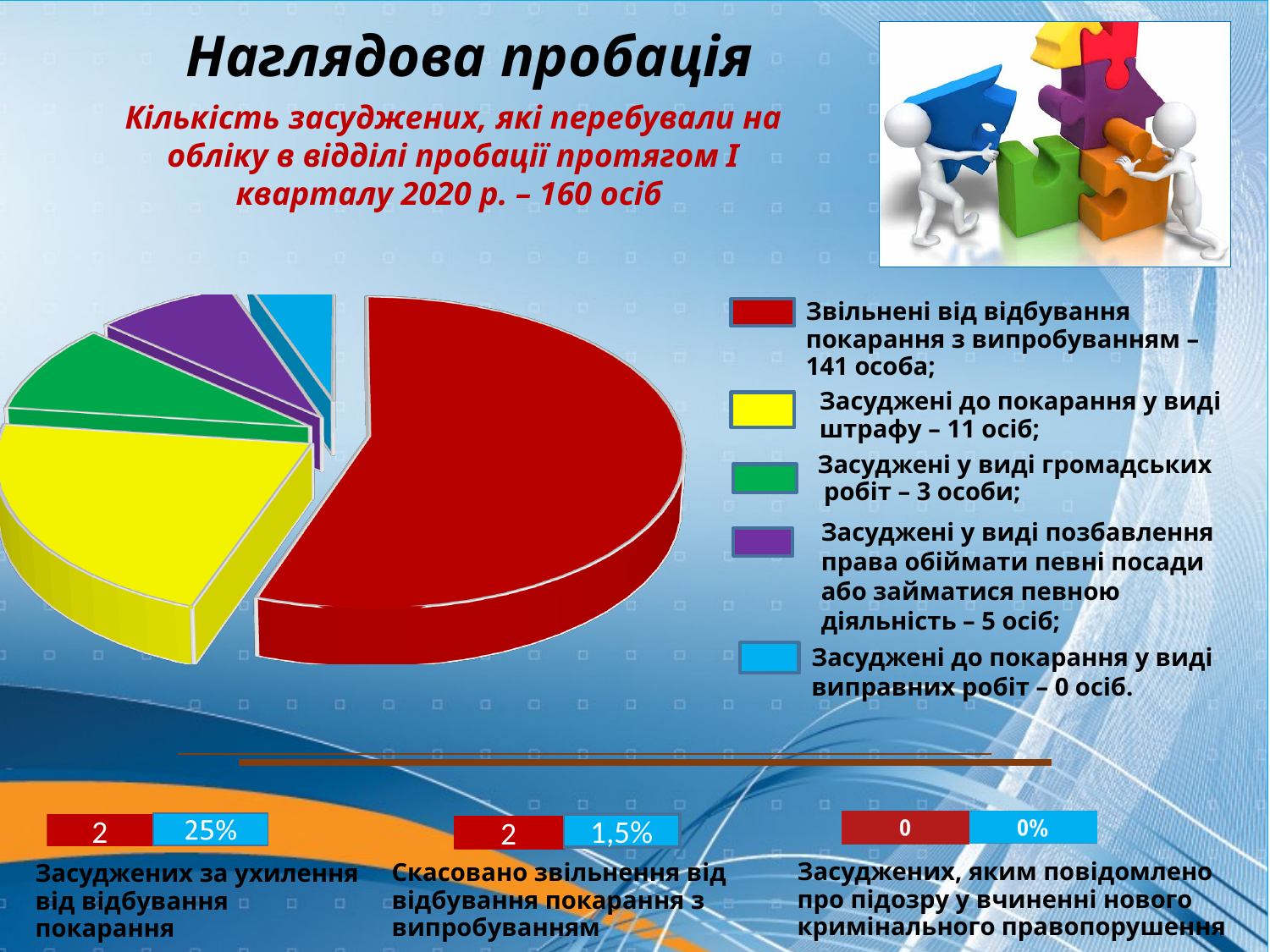
How many people were released from serving a sentence with probation (Звільнені від відбування покарання з випробуванням)? 141 особа How many categories does the pie chart's legend list? 5 Which category has the smallest value in the pie chart? Засуджені до покарання у виді виправних робіт How many people were sentenced to deprivation of the right to hold certain positions (позбавлення права обіймати певні посади)? 5 осіб What colour is the largest slice of the pie chart? red How many people were sentenced to community service (громадських робіт)? 3 особи Which category has the largest slice of the pie chart? Звільнені від відбування покарання з випробуванням What kind of chart is shown on the slide? pie chart Which is larger: the number sentenced to a fine or the number sentenced to community service? sentenced to a fine (штрафу) What is the total number of convicted persons on record stated in the subtitle? 160 осіб What is the difference between the number released with probation (141) and the number sentenced to a fine (11)? 130 How many people were sentenced to a fine (Засуджені до покарання у виді штрафу)? 11 осіб